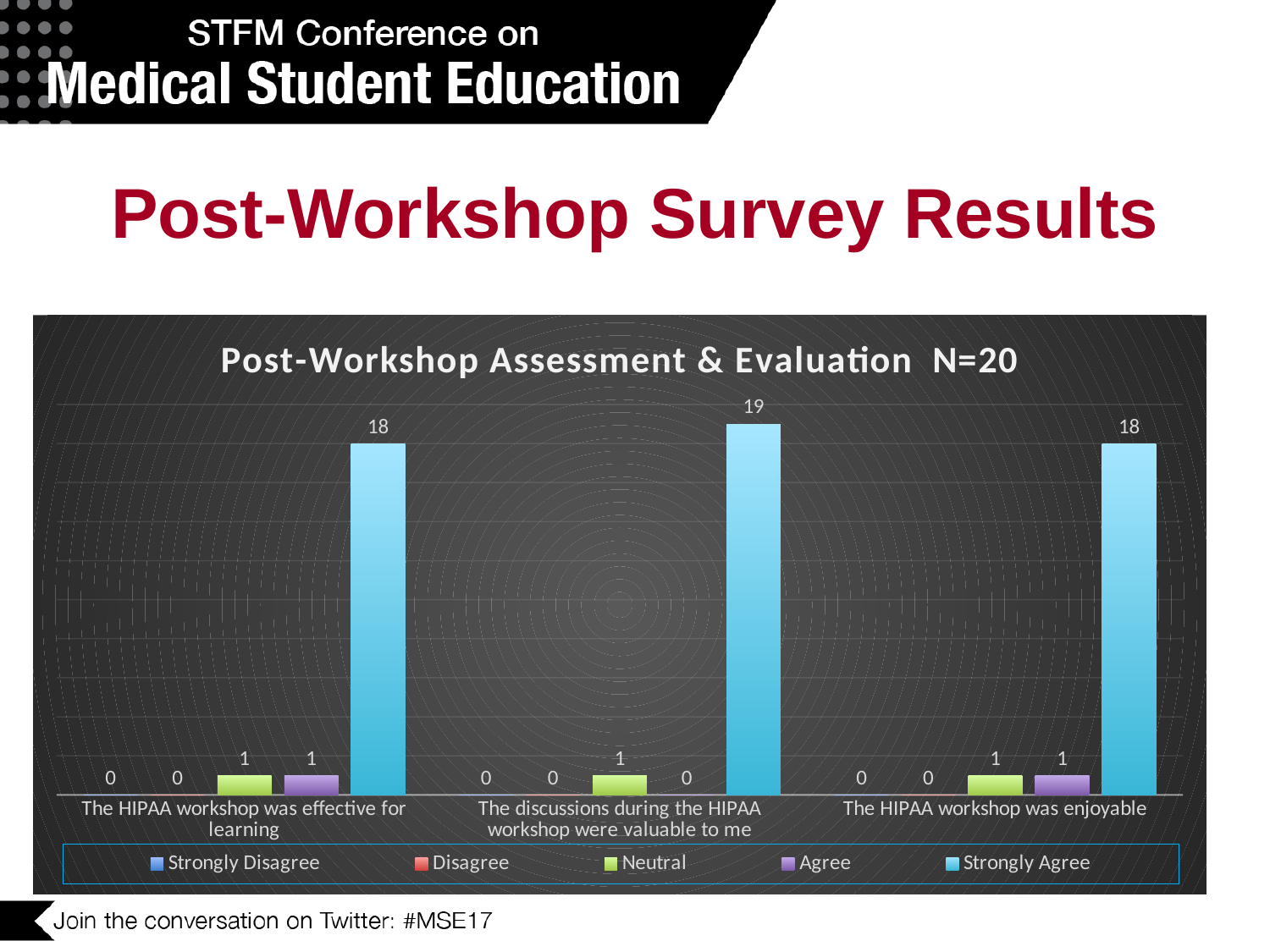
How many categories are shown on the x axis? 3 What is the value for Strongly Agree for 'The discussions during the HIPAA workshop were valuable to me'? 19 Which category has the highest Strongly Agree value? The discussions during the HIPAA workshop were valuable to me Which is larger for 'The HIPAA workshop was effective for learning': the Neutral value or the Strongly Agree value? Strongly Agree What is the value for Agree for 'The discussions during the HIPAA workshop were valuable to me'? 0 What is the value for Agree for 'The HIPAA workshop was enjoyable'? 1 How many series does the legend list? 5 What kind of chart is shown on the slide? Bar chart What is the value for Strongly Agree for 'The HIPAA workshop was effective for learning'? 18 What is the title of the chart? Post-Workshop Assessment & Evaluation N=20 Which series is shown in light blue in the legend? Strongly Agree What is the difference between the Strongly Agree values for 'The discussions during the HIPAA workshop were valuable to me' and 'The HIPAA workshop was enjoyable'? 1